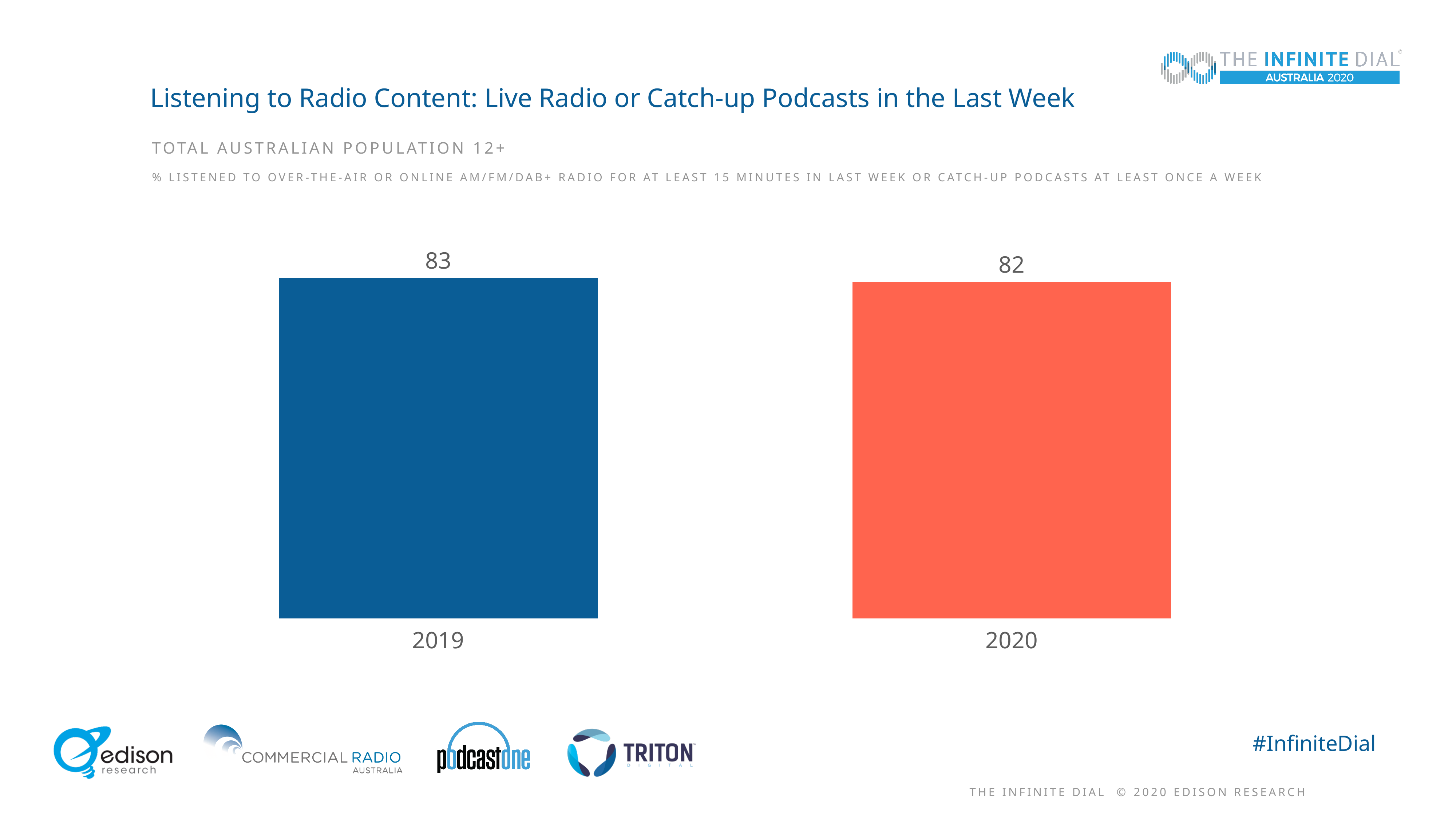
What is the value for 2020? 82 What is the difference between the 2019 and 2020 values? 1 Do the values rise or fall from 2019 to 2020? fall How many years are shown in the chart? 2 What kind of chart is shown on the slide? bar chart Which year has the higher value? 2019 Is the value for 2019 larger or smaller than the value for 2020? larger What is the title of the chart? Listening to Radio Content: Live Radio or Catch-up Podcasts in the Last Week What colour is the bar for 2020? red Which year has the lower value? 2020 What is the value for 2019? 83